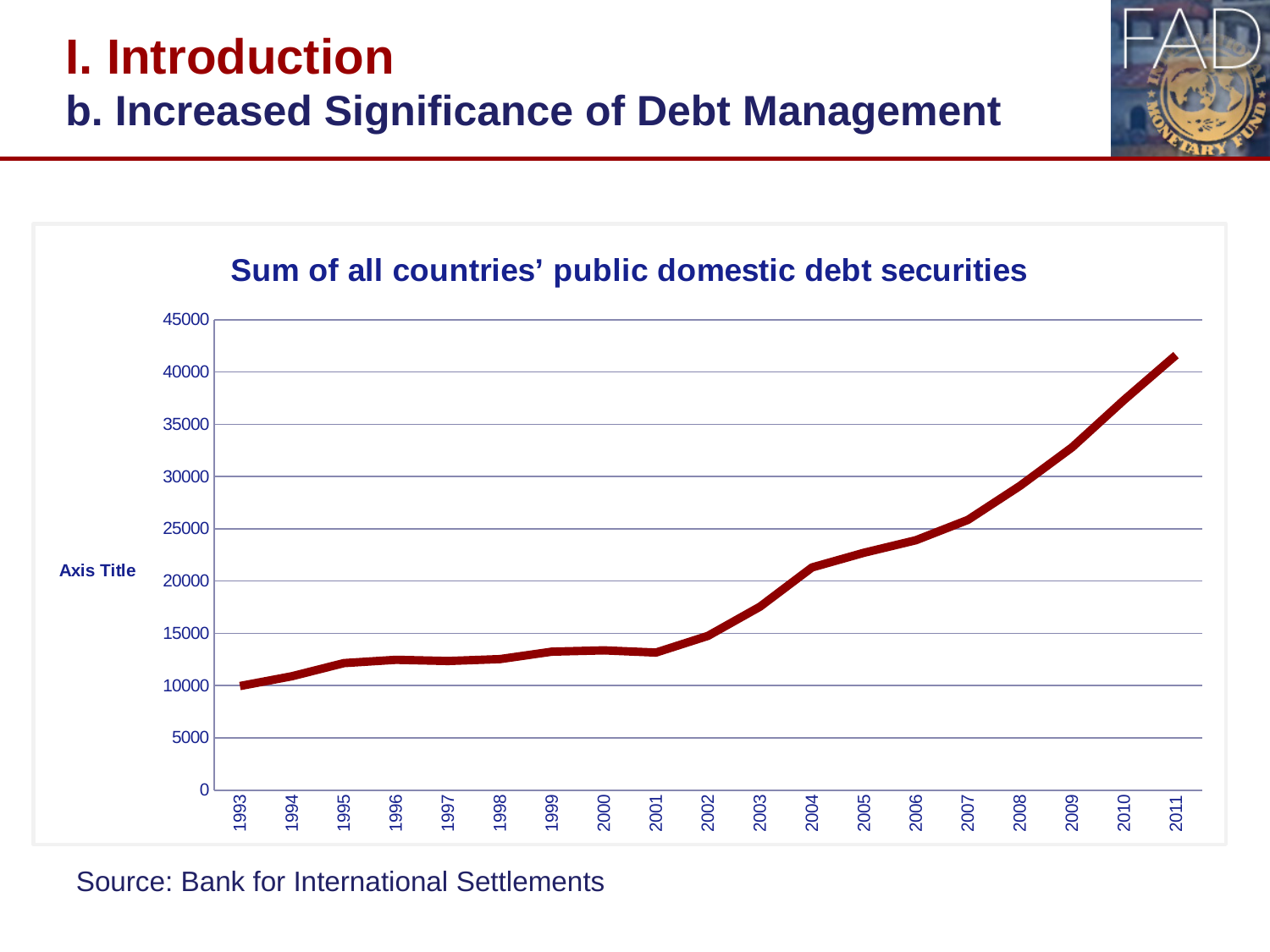
What is the source cited below the chart? Bank for International Settlements Do the values generally rise or fall from 1993 to 2011? rise Is the value for 2011 greater or less than 40000? greater How many years are plotted along the x axis of the chart? 19 Which year has the highest value in the chart? 2011 Is the value for 2001 greater or less than 15000? less Is the value for 2003 greater or less than 20000? less What is the title of the chart? Sum of all countries' public domestic debt securities Which year has the lowest value in the chart? 1993 Which year has the larger value, 2004 or 1998? 2004 What kind of chart is shown on the slide? line chart